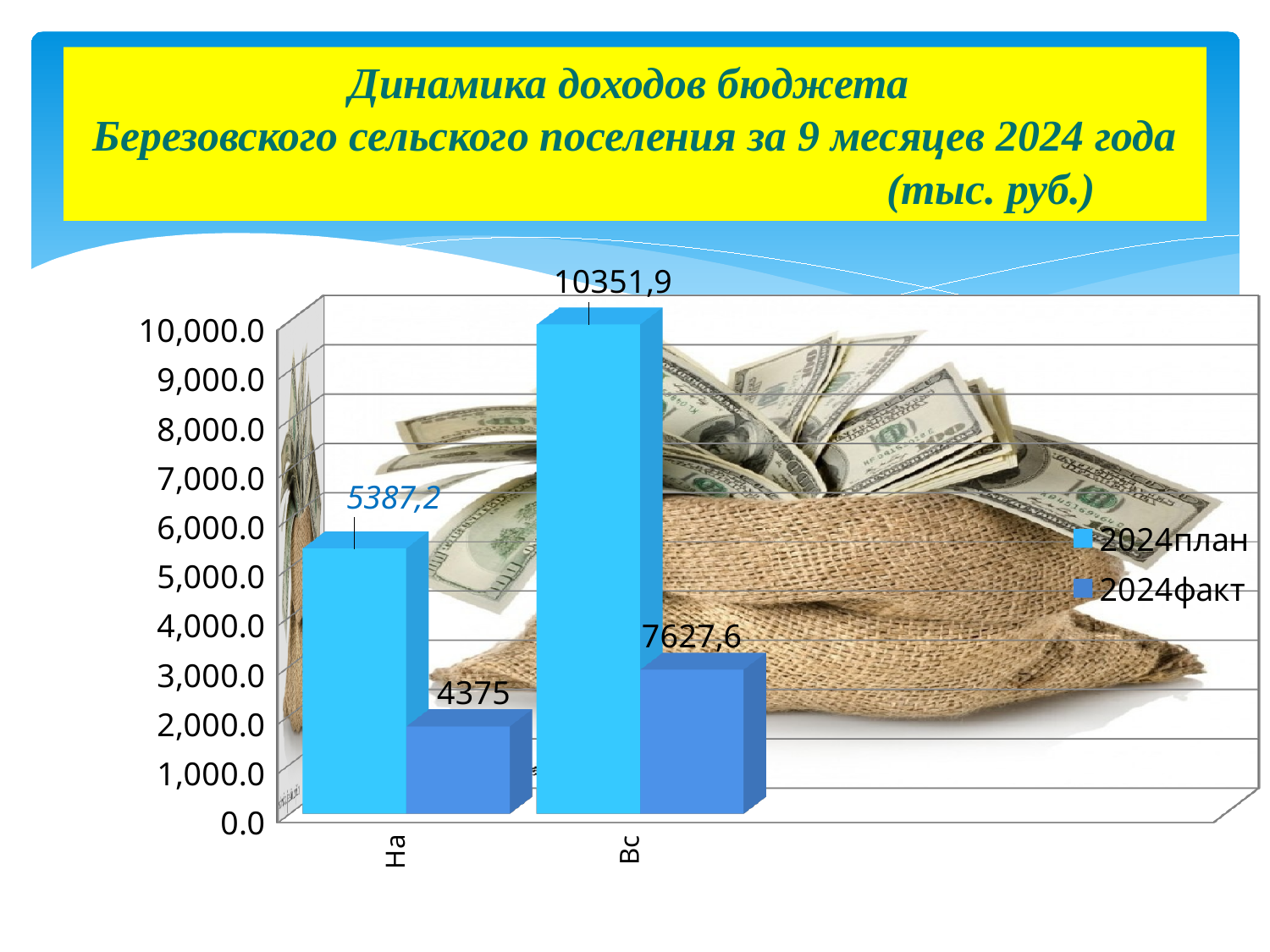
For the category "На", which is larger: the 2024план value or the 2024факт value? 2024план What is the 2024план value for the category labelled "На"? 5387,2 What unit is stated in the slide title for the values? тыс. руб. What is the difference between the 2024план and 2024факт values for the category "Вс"? 2724,3 What is the 2024факт value for the category labelled "Вс"? 7627,6 What is the 2024факт value for the category labelled "На"? 4375 What kind of chart is shown on the slide? Bar chart What is the 2024план value for the category labelled "Вс"? 10351,9 How many series does the legend list? 2 What is the difference between the 2024план and 2024факт values for the category "На"? 1012,2 Which bar on the chart has the lowest value? 2024факт for На Which bar on the chart has the highest value? 2024план for Вс